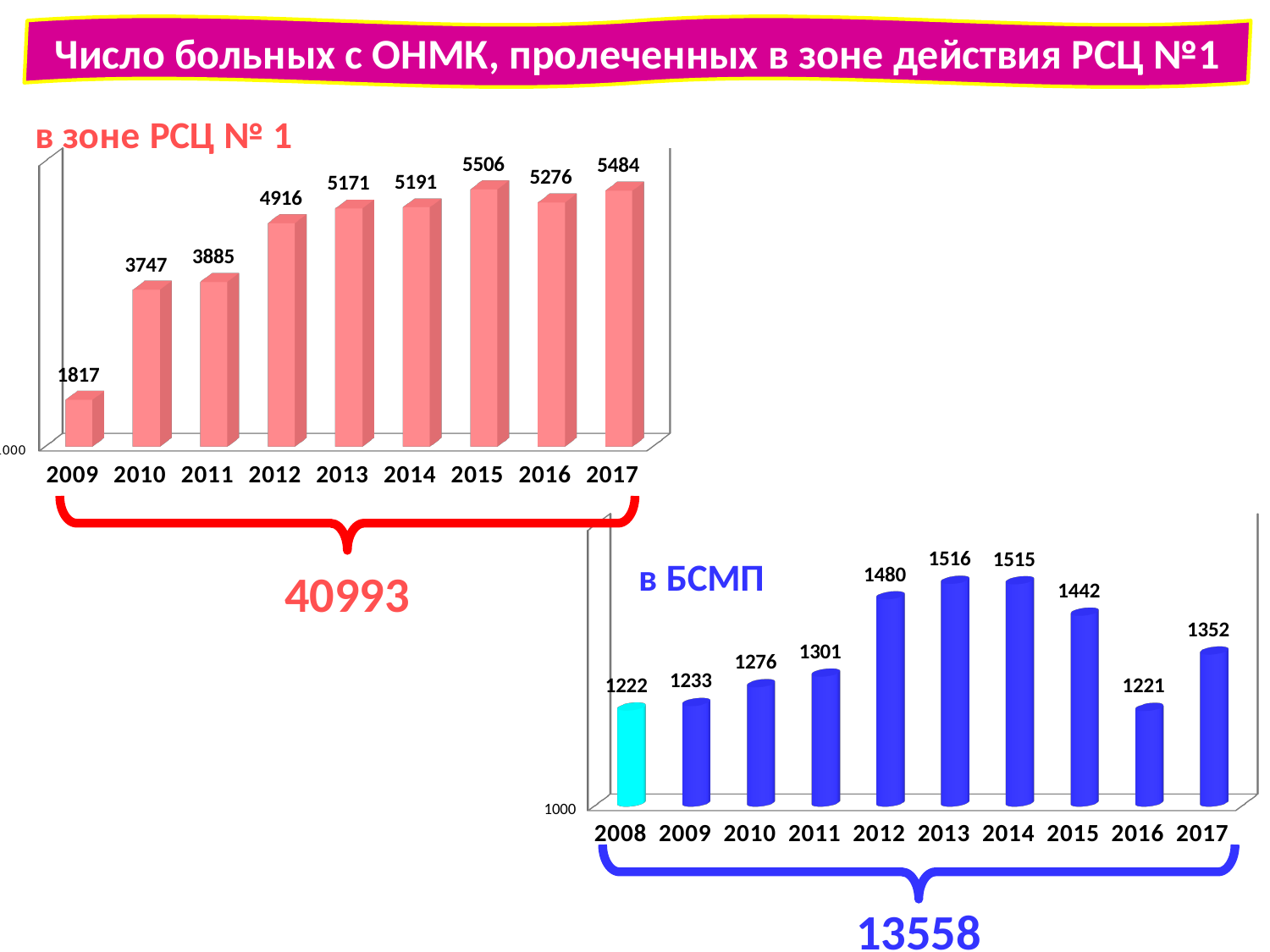
In the chart titled "в зоне РСЦ № 1", which year has the highest value? 2015 In the chart titled "в БСМП", what is the value for 2015? 1442 In the chart titled "в зоне РСЦ № 1", what is the difference between the values for 2010 and 2009? 1930 In the chart titled "в БСМП", is the value for 2012 larger or smaller than the value for 2011? larger What kind of chart is the chart titled "в БСМП"? bar chart In the chart titled "в зоне РСЦ № 1", how many years are shown on the x axis? 9 In the chart titled "в зоне РСЦ № 1", which year has the lowest value? 2009 In the chart titled "в БСМП", what is the difference between the values for 2017 and 2016? 131 In the chart titled "в БСМП", how many years are shown on the x axis? 10 In the chart titled "в зоне РСЦ № 1", what is the value for 2012? 4916 In the chart titled "в зоне РСЦ № 1", is the value for 2016 larger or smaller than the value for 2017? smaller In the chart titled "в БСМП", what is the value for 2008? 1222